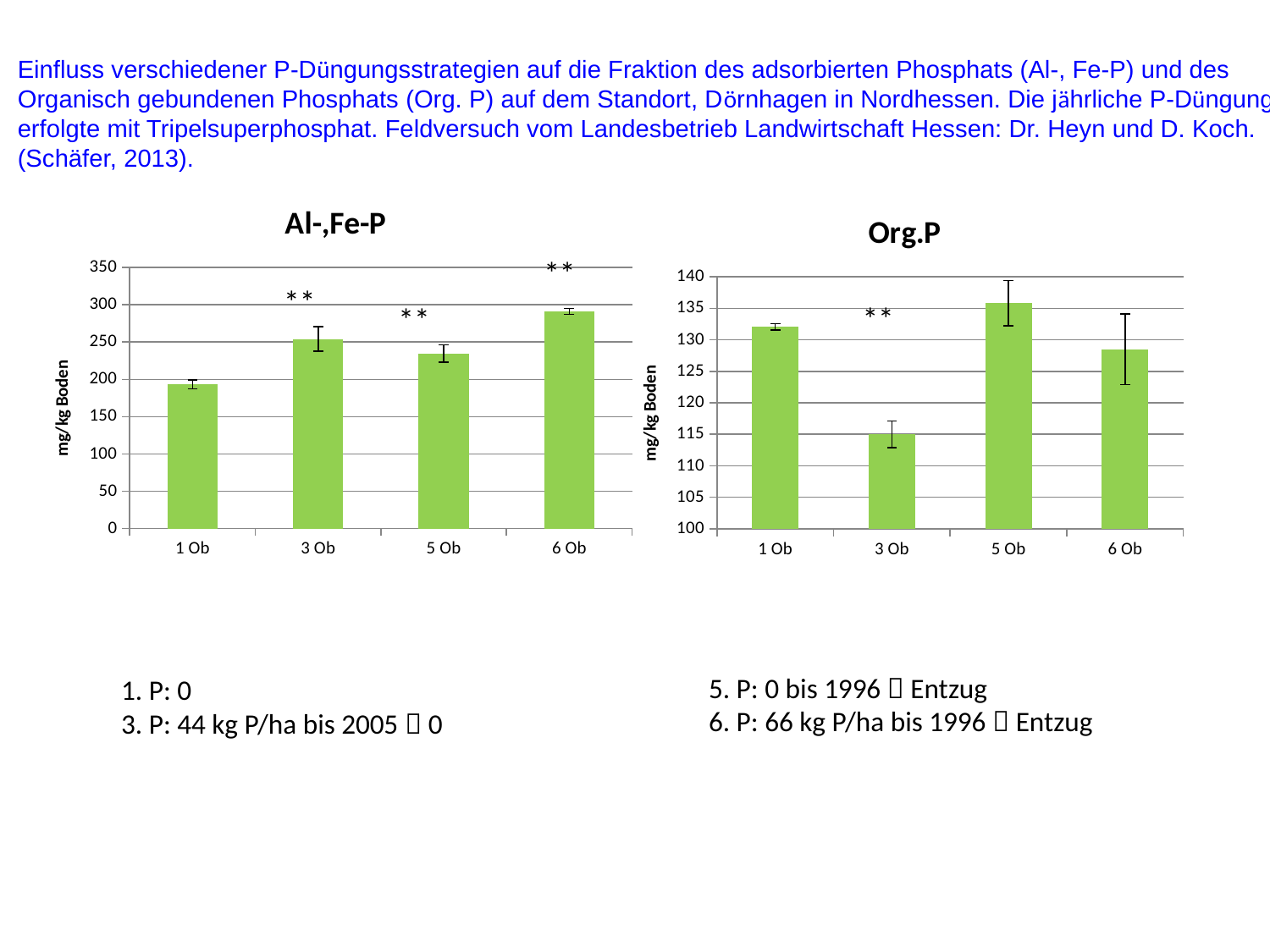
In the Al-,Fe-P chart, which category has the highest value? 6 Ob In the Al-,Fe-P chart, which category has the lowest value? 1 Ob What kind of chart is the Al-,Fe-P chart on the left? bar chart How many categories are shown on the x axis of the Org.P chart? 4 In the Org.P chart, which is larger, the value for 1 Ob or the value for 3 Ob? 1 Ob What is the y-axis label of the Org.P chart? mg/kg Boden In the Al-,Fe-P chart, which is larger, the value for 3 Ob or the value for 1 Ob? 3 Ob In the Al-,Fe-P chart, is the value for 6 Ob greater or less than 250? greater In the Org.P chart, is the value for 6 Ob greater or less than 125? greater In the Org.P chart, is the value for 3 Ob greater or less than 120? less In the Org.P chart, which category has the lowest value? 3 Ob